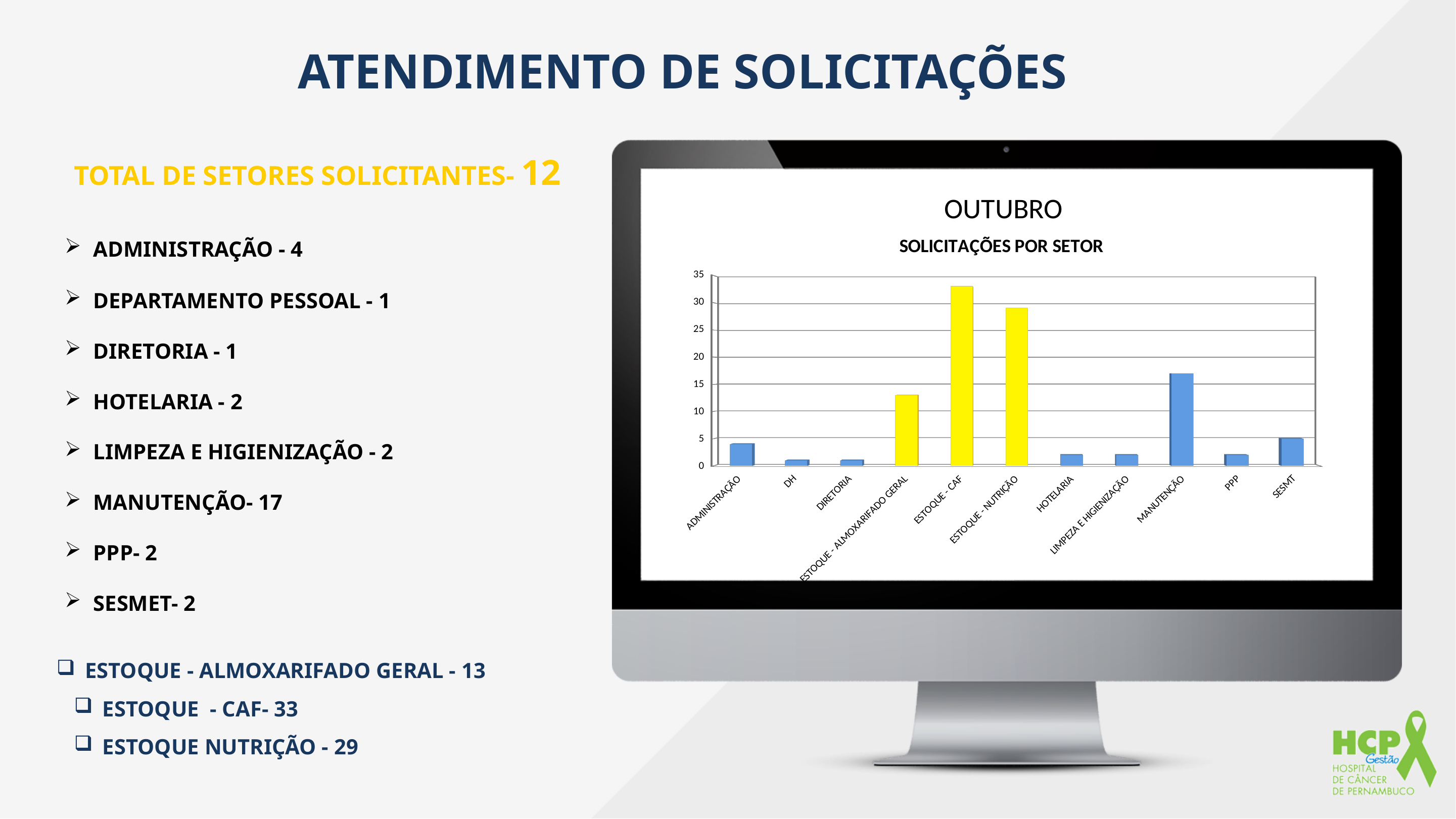
Is the value for ESTOQUE - ALMOXARIFADO GERAL greater or less than 10? greater Which sector has the highest number of solicitações in the chart? ESTOQUE - CAF Which is larger, the value for ADMINISTRAÇÃO or the value for HOTELARIA? ADMINISTRAÇÃO Is the value for ESTOQUE - CAF greater or less than 30? greater Is the value for MANUTENÇÃO greater or less than 20? less Which bars in the chart are coloured yellow? ESTOQUE - ALMOXARIFADO GERAL, ESTOQUE - CAF and ESTOQUE - NUTRIÇÃO Which is larger, the value for MANUTENÇÃO or the value for ESTOQUE - ALMOXARIFADO GERAL? MANUTENÇÃO How many sectors (categories) are shown on the x axis of the chart? 11 According to the slide, how many solicitações did ESTOQUE - CAF have? 33 What kind of chart is shown on the slide? bar chart What is the title of the chart? SOLICITAÇÕES POR SETOR